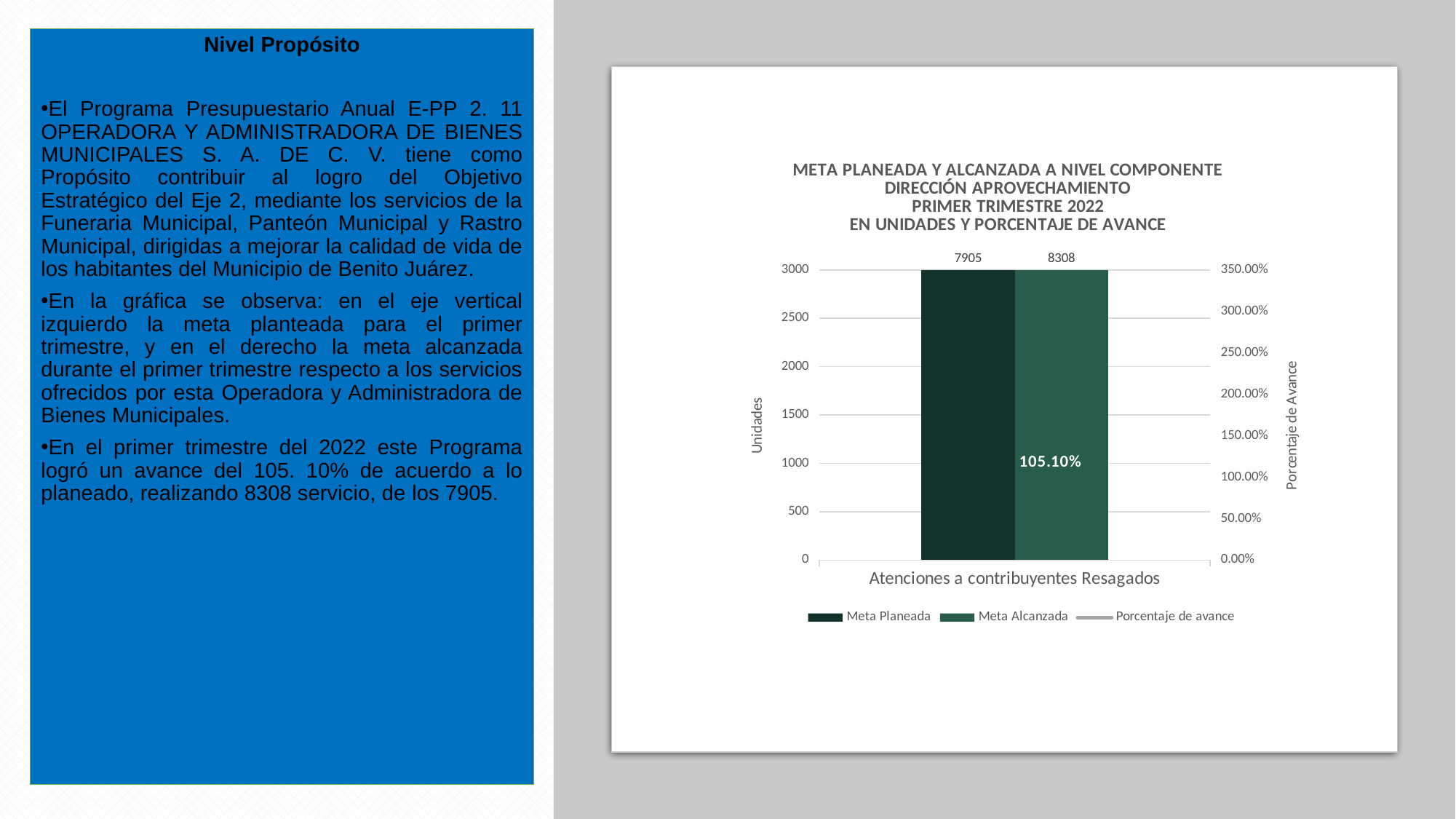
How many categories are shown on the x axis? 1 What is the value of Meta Planeada for Atenciones a contribuyentes Resagados? 7905 What is the label of the category on the x axis? Atenciones a contribuyentes Resagados What is the value of Meta Alcanzada for Atenciones a contribuyentes Resagados? 8308 How many series does the legend list? 3 Which is larger, Meta Planeada or Meta Alcanzada? Meta Alcanzada What is the difference between Meta Alcanzada and Meta Planeada? 403 What is the title of the left vertical axis? Unidades What is the Porcentaje de avance shown on the chart? 105.10% What kind of chart is shown on the slide? bar chart Is the value for Meta Planeada greater or less than 3000? greater